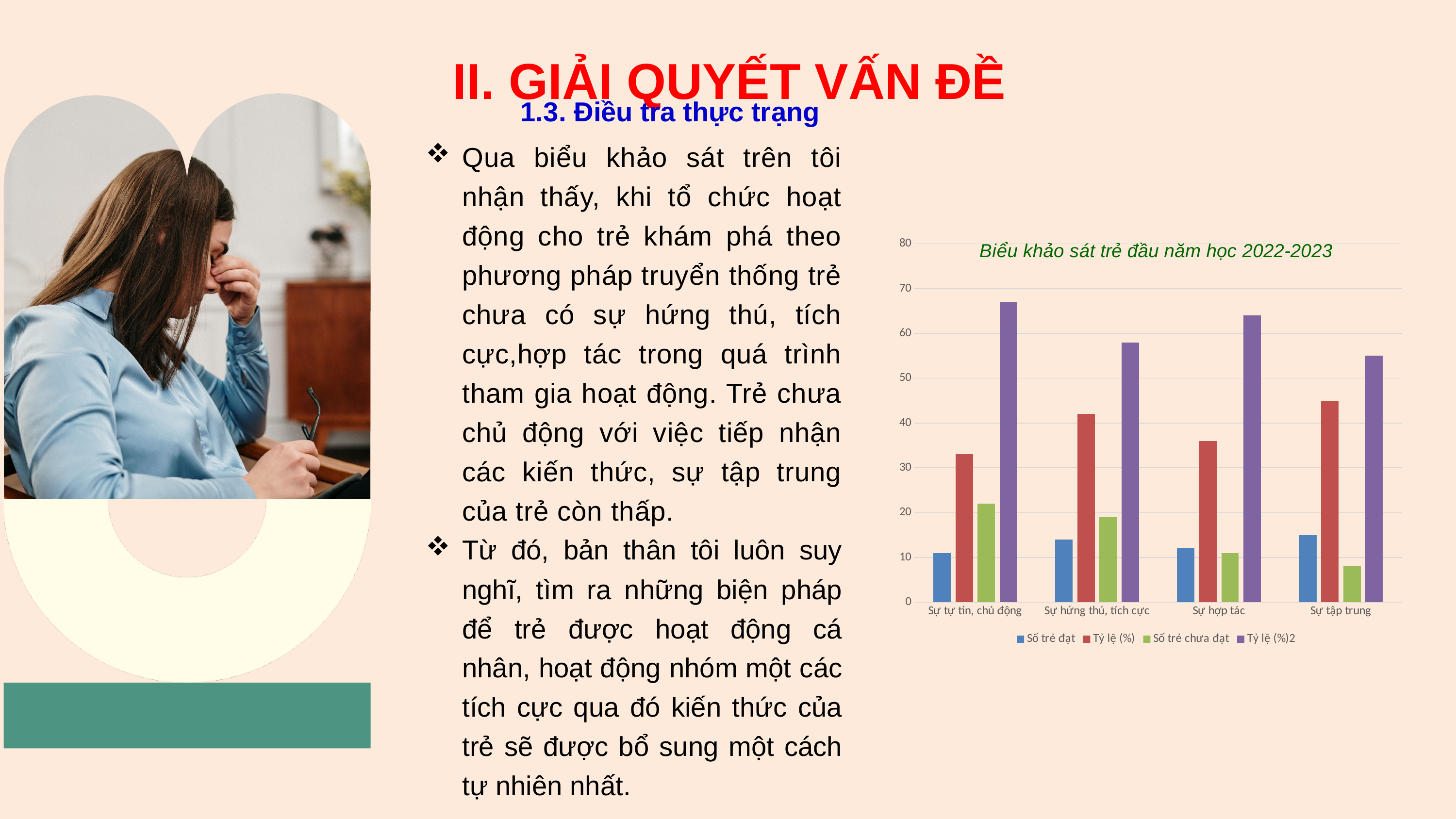
What kind of chart is shown on the slide? bar chart Is the value of Tỷ lệ (%)2 for Sự tập trung greater or less than 60? less Is the value of Tỷ lệ (%) for Sự tự tin, chủ động greater or less than 30? greater Is the value of Tỷ lệ (%)2 for Sự tự tin, chủ động greater or less than 60? greater How many series does the chart legend list? 4 For Sự tập trung, which is larger: Số trẻ đạt or Số trẻ chưa đạt? Số trẻ đạt What colour represents the series Tỷ lệ (%)2 in the chart? purple What is the title of the chart? Biểu khảo sát trẻ đầu năm học 2022-2023 How many categories are shown on the x axis of the chart? 4 Which series has the tallest bar in every category of the chart? Tỷ lệ (%)2